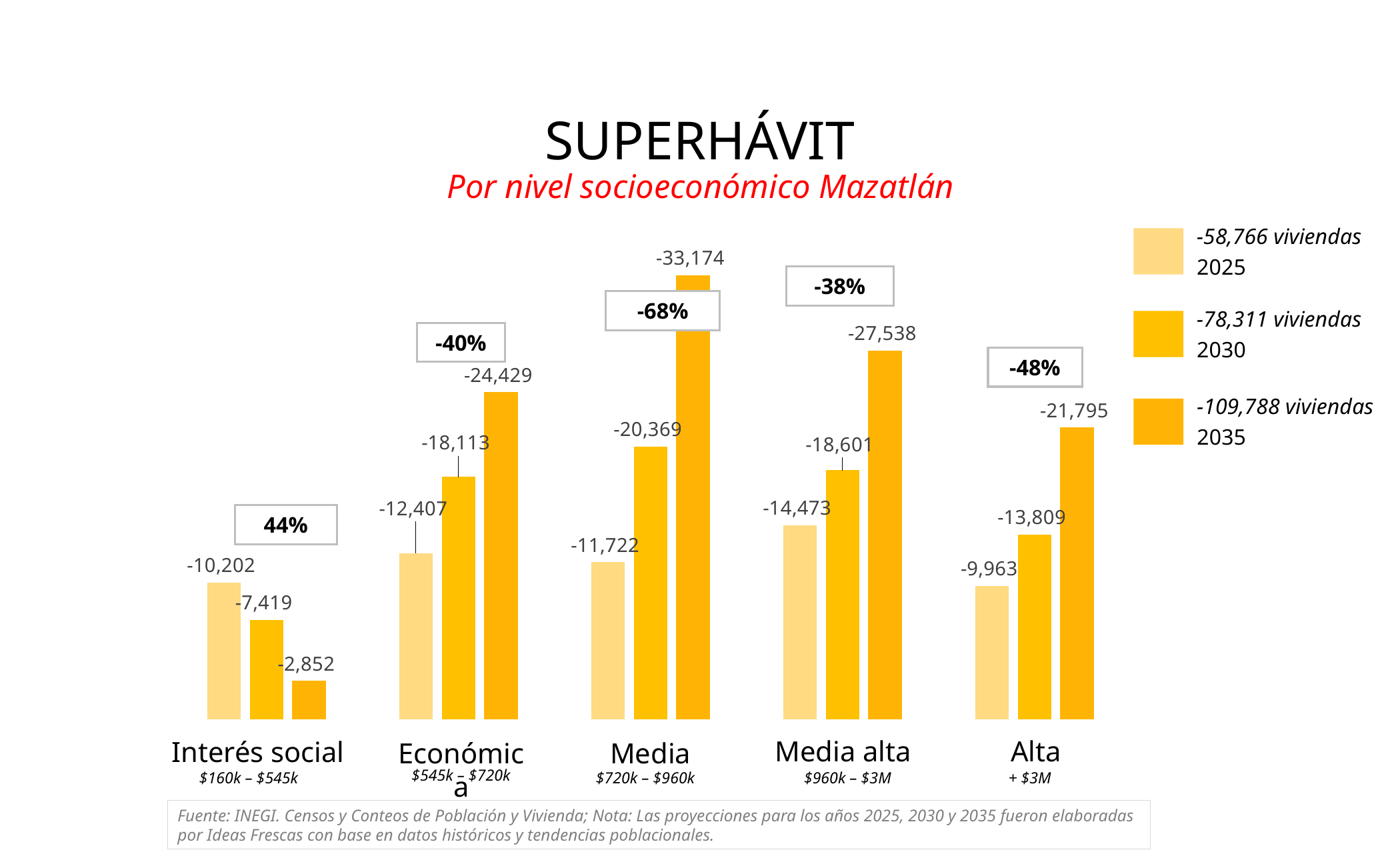
Which category has the shortest bar for 2035? Interés social What is the value shown for Interés social in 2025? -10,202 What total number of viviendas does the legend give for 2035? -109,788 viviendas How many socioeconomic categories are shown on the x axis? 5 What is the value shown for Alta in 2030? -13,809 What kind of chart is shown on the slide? Bar chart Which bar is taller: Económica 2035 or Media alta 2035? Media alta 2035 How many series does the legend list? 3 Which category has the tallest bar for 2035? Media By how much does the magnitude of the Media value change between 2025 (-11,722) and 2035 (-33,174)? 21,452 What is the value shown for Media in 2035? -33,174 Which category has the tallest bar for 2025? Media alta